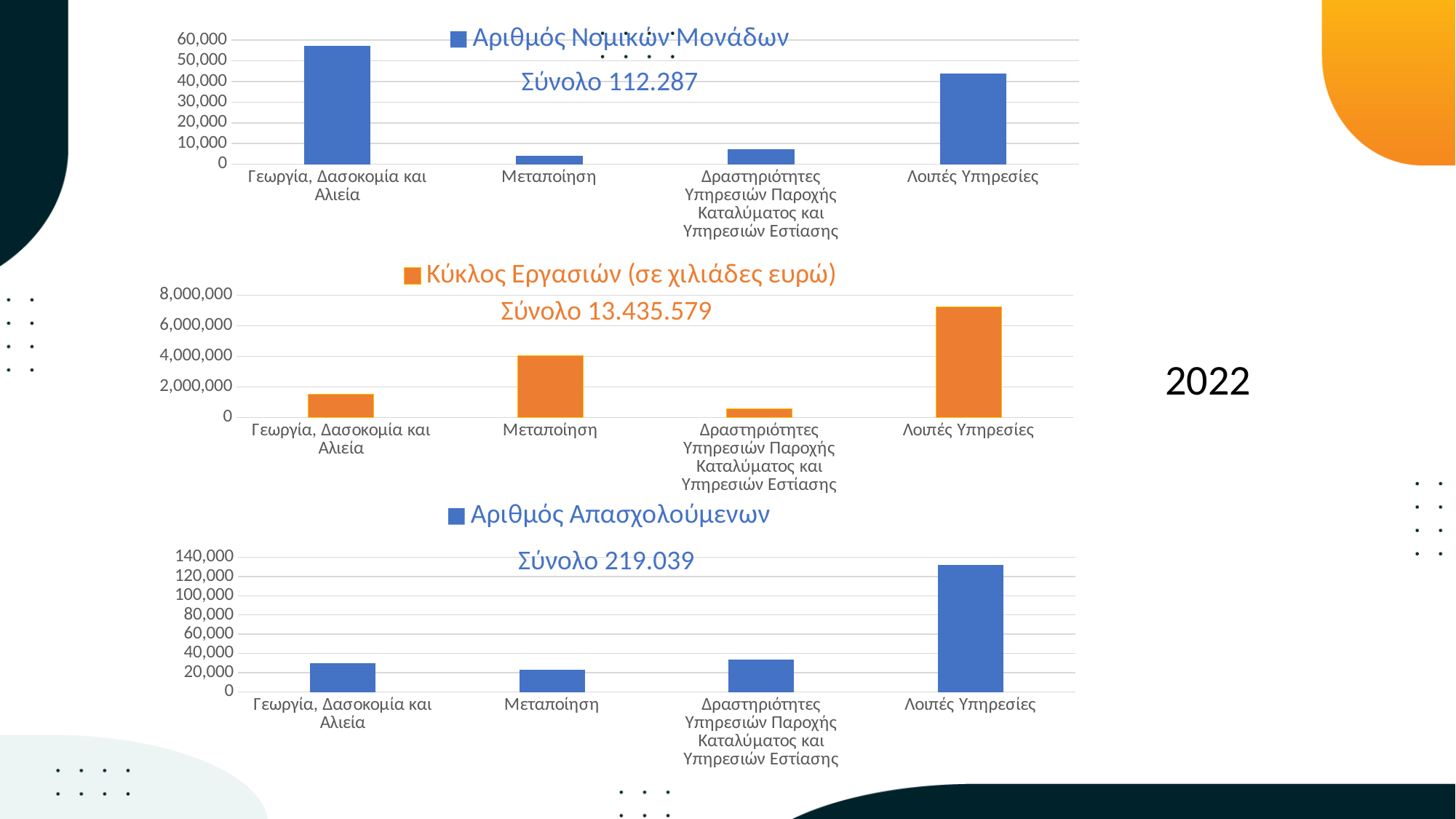
In the chart titled 'Αριθμός Απασχολούμενων', is the value for Λοιπές Υπηρεσίες greater or less than 120,000? greater In the chart titled 'Κύκλος Εργασιών (σε χιλιάδες ευρώ)', is the value for Λοιπές Υπηρεσίες greater or less than 6,000,000? greater In the chart titled 'Αριθμός Νομικών Μονάδων', which category has the lowest value? Μεταποίηση In the chart titled 'Κύκλος Εργασιών (σε χιλιάδες ευρώ)', which category has the highest value? Λοιπές Υπηρεσίες In the chart titled 'Αριθμός Απασχολούμενων', how many categories are shown on the x axis? 4 In the chart titled 'Αριθμός Απασχολούμενων', which category has the highest value? Λοιπές Υπηρεσίες In the chart titled 'Αριθμός Νομικών Μονάδων', which category has the highest value? Γεωργία, Δασοκομία και Αλιεία In the chart titled 'Κύκλος Εργασιών (σε χιλιάδες ευρώ)', which is larger: Μεταποίηση or Γεωργία, Δασοκομία και Αλιεία? Μεταποίηση What kind of chart is the chart titled 'Κύκλος Εργασιών (σε χιλιάδες ευρώ)'? bar chart In the chart titled 'Κύκλος Εργασιών (σε χιλιάδες ευρώ)', which category has the lowest value? Δραστηριότητες Υπηρεσιών Παροχής Καταλύματος και Υπηρεσιών Εστίασης In the chart titled 'Αριθμός Νομικών Μονάδων', is the value for Λοιπές Υπηρεσίες greater or less than 50,000? less What total (Σύνολο) is printed on the chart titled 'Αριθμός Νομικών Μονάδων'? 112.287